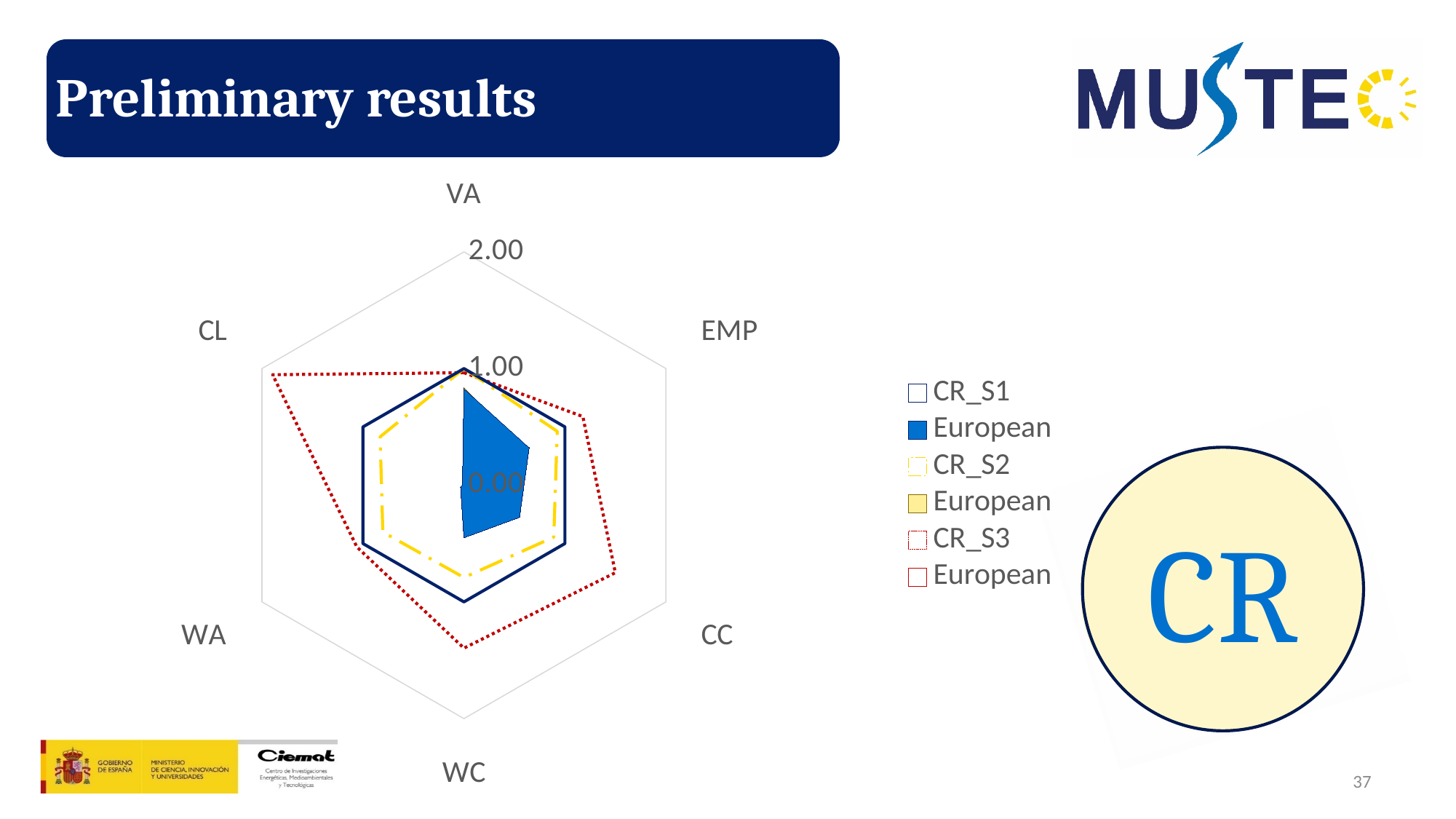
Is the CR_S3 value for CL greater or less than 1.00? greater Is the CR_S3 value for CC greater or less than 1.00? greater Which series has the larger value for WC, CR_S1 or the filled blue European series? CR_S1 How many axes (categories) does the radar chart have? 6 What kind of chart is shown on the slide? Radar chart Is the CR_S2 value for WC greater or less than 1.00? less What is the highest value shown on the radar chart's axis scale? 2.00 Which category is labelled at the top of the radar chart? VA Which category has the highest value for the CR_S3 series? CL Which series has the larger value for CC, CR_S3 or CR_S2? CR_S3 How many entries does the legend of the radar chart list? 6